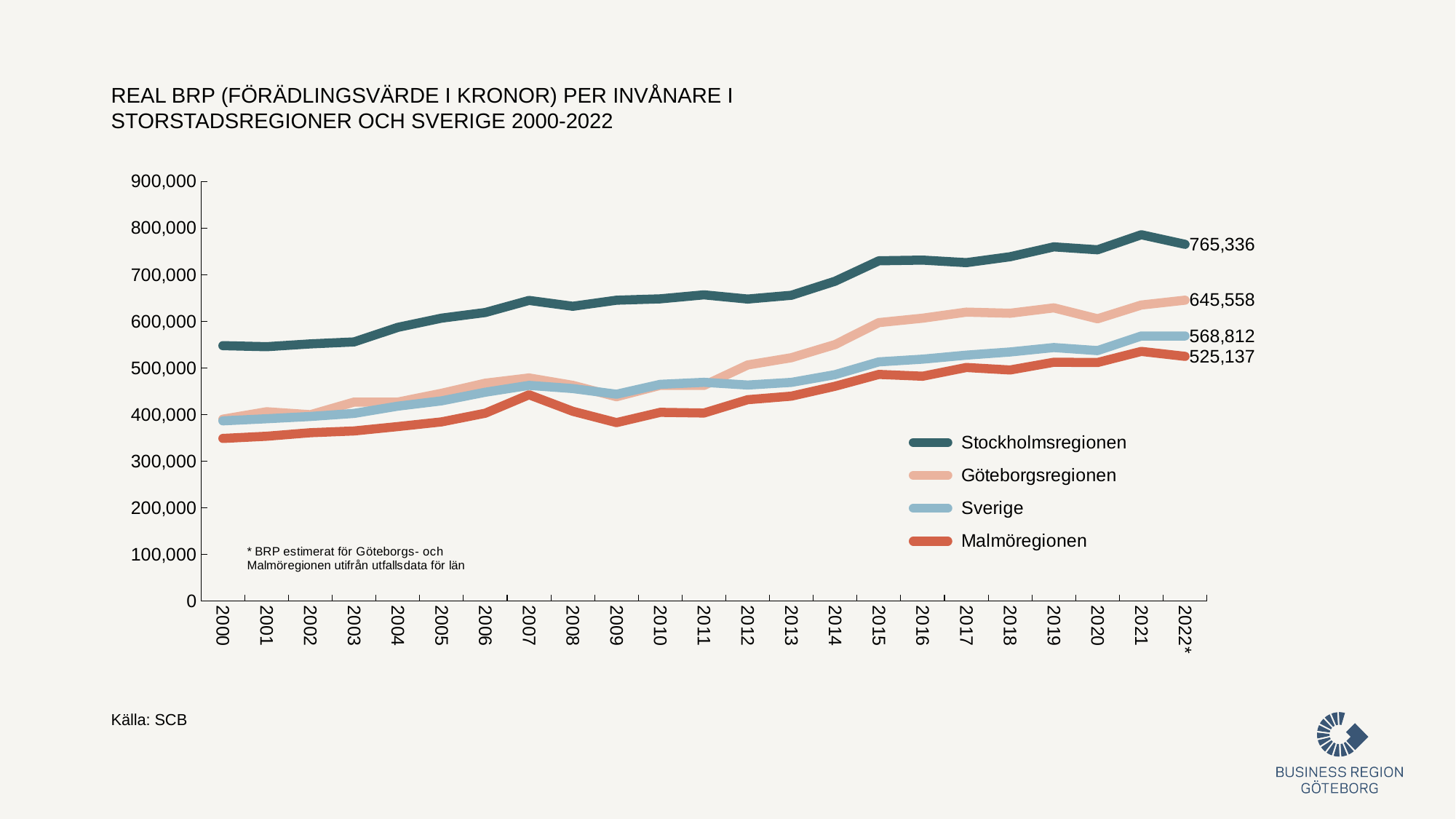
What is the value for Sverige in 2022*? 568,812 What is the difference between Sverige and Malmöregionen in 2022*? 43,675 Which series has the lowest value in 2022*? Malmöregionen Is the value for Stockholmsregionen in 2015 greater or less than 700,000? greater What is the difference between Stockholmsregionen and Göteborgsregionen in 2022*? 119,778 What is the value for Malmöregionen in 2022*? 525,137 Which series has the highest value in 2022*? Stockholmsregionen How many series does the legend list? 4 What is the value for Stockholmsregionen in 2022*? 765,336 Is the value for Malmöregionen in 2000 greater or less than 400,000? less What is the value for Göteborgsregionen in 2022*? 645,558 What kind of chart is shown on the slide? Line chart